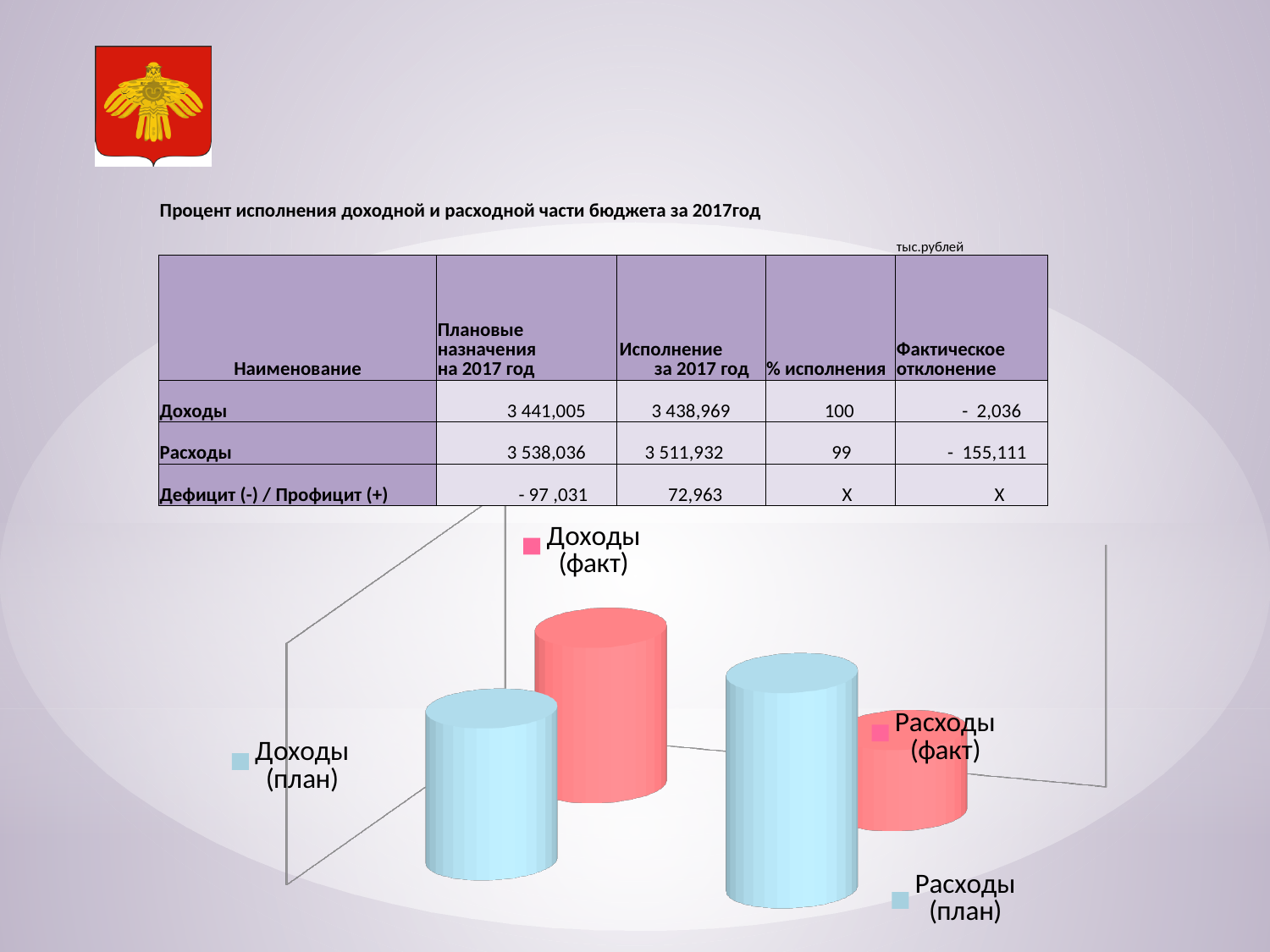
How many bars (cylinders) are plotted in the chart? 4 In the chart, which bar is taller: Расходы (план) or Доходы (план)? Расходы (план) What kind of chart is shown at the bottom of the slide? bar chart What colour are the bars for Доходы (план) and Расходы (план) in the chart? light blue What colour is the bar for Доходы (факт) in the chart? pink/red